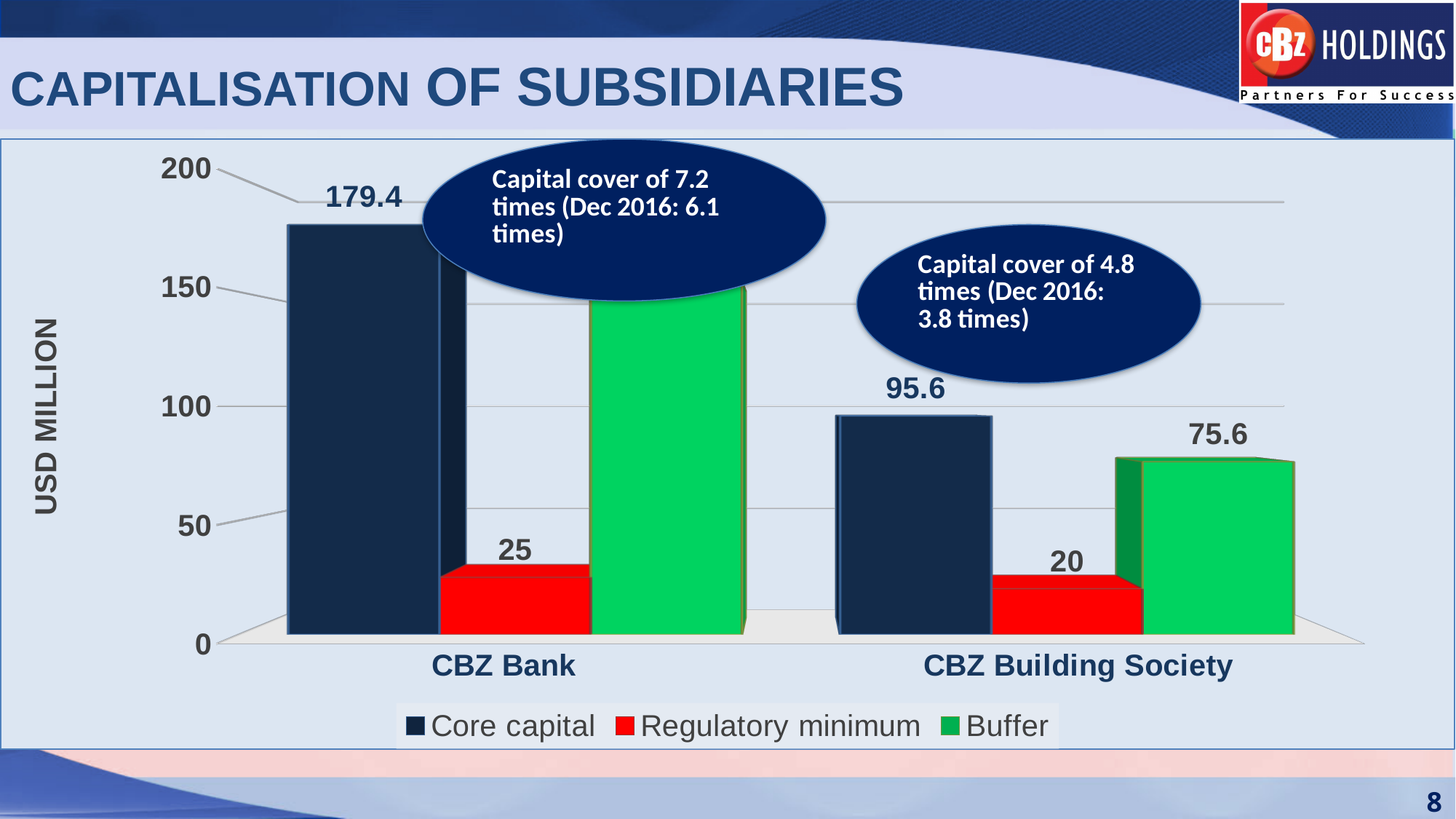
What is the Buffer value for CBZ Building Society? 75.6 What kind of chart is shown on the slide? bar chart What is the Regulatory minimum value for CBZ Building Society? 20 What is the Core capital value for CBZ Building Society? 95.6 Which has the larger Core capital, CBZ Bank or CBZ Building Society? CBZ Bank What is the label on the vertical axis of the chart? USD MILLION What is the Core capital value for CBZ Bank? 179.4 Which series has the lowest value for CBZ Building Society? Regulatory minimum What is the difference in Core capital between CBZ Bank and CBZ Building Society? 83.8 Is the Buffer value for CBZ Bank greater or less than 100? greater How many series does the legend list? 3 What is the difference in Regulatory minimum between CBZ Bank and CBZ Building Society? 5